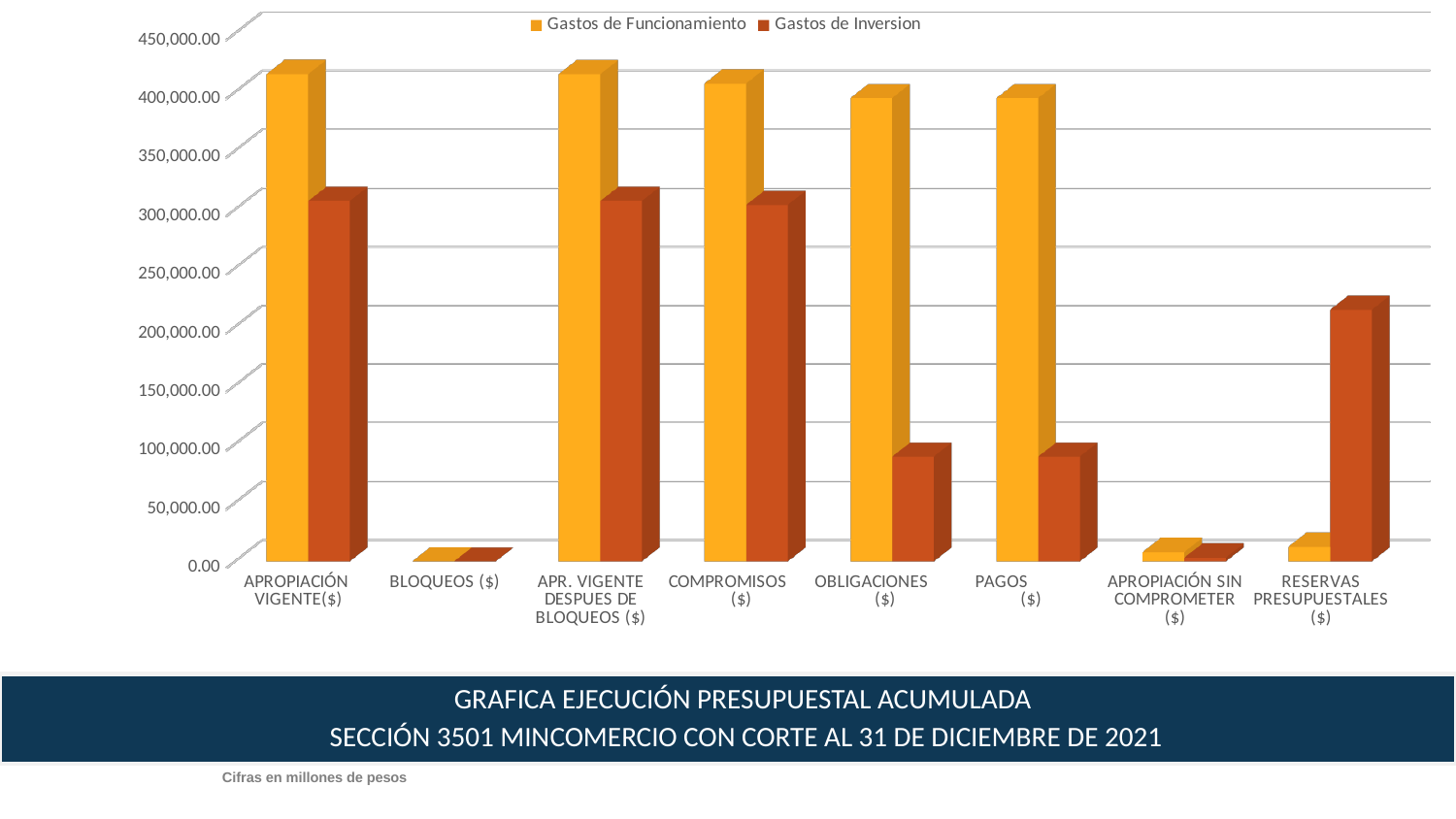
How many categories are shown on the x axis? 8 Is the Gastos de Inversion value for OBLIGACIONES ($) greater or less than 100,000.00? less Is the Gastos de Funcionamiento value for APROPIACIÓN VIGENTE($) greater or less than 350,000.00? greater Which category has the lowest value for Gastos de Funcionamiento? BLOQUEOS ($) What kind of chart is shown on the slide? Bar chart Which category has the lowest value for Gastos de Inversion? BLOQUEOS ($) For OBLIGACIONES ($), which series has the larger value, Gastos de Funcionamiento or Gastos de Inversion? Gastos de Funcionamiento What are the two series named in the legend? Gastos de Funcionamiento and Gastos de Inversion Is the Gastos de Inversion value for COMPROMISOS ($) greater or less than 250,000.00? greater How many series does the legend list? 2 For RESERVAS PRESUPUESTALES ($), which series has the larger value, Gastos de Funcionamiento or Gastos de Inversion? Gastos de Inversion